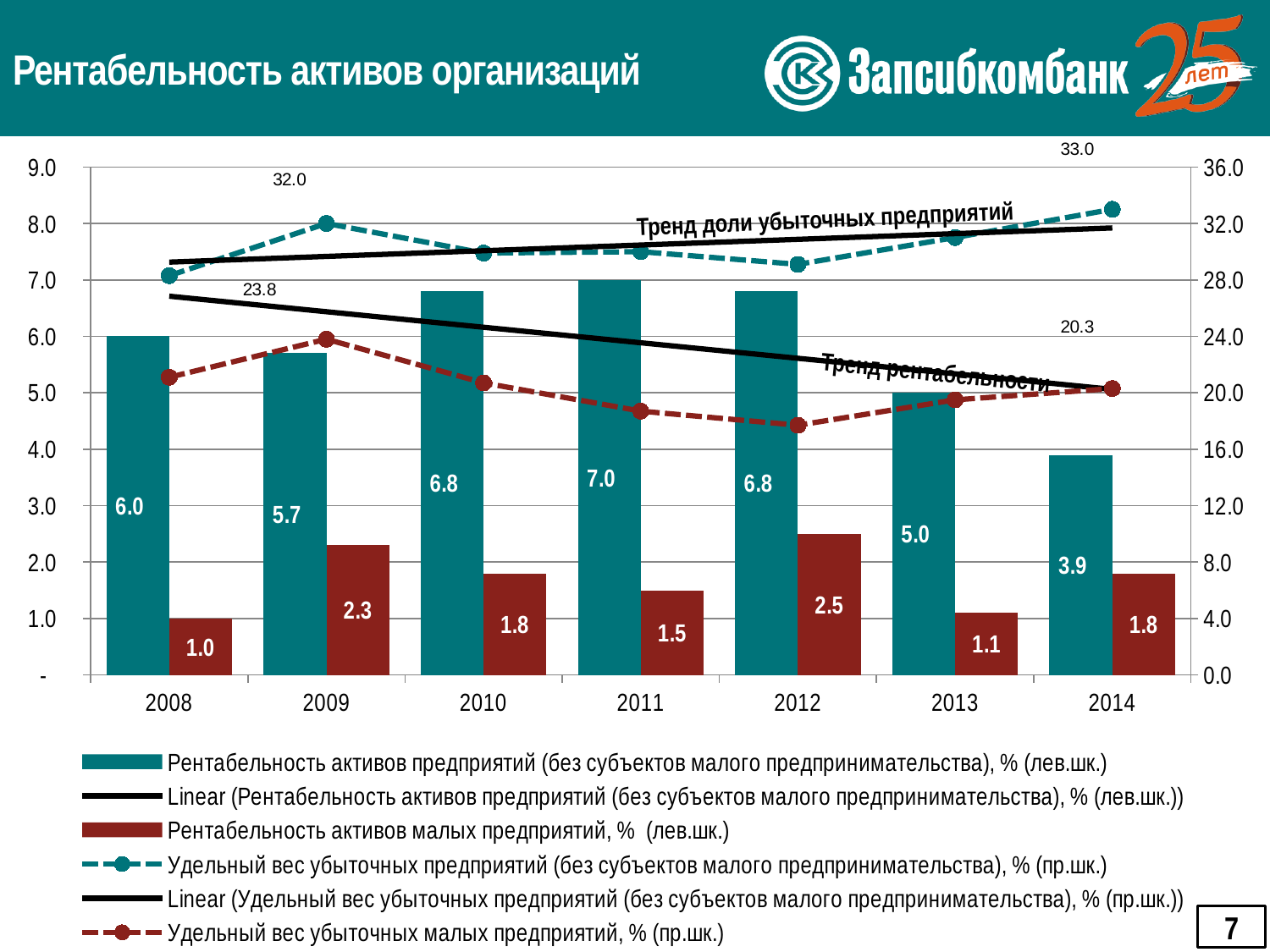
What is the value of the teal bar (Рентабельность активов предприятий, без субъектов малого предпринимательства) for 2011? 7.0 In which year is the dark red bar (Рентабельность активов малых предприятий) lowest? 2008 How many series does the legend list? 6 What is the labelled value of the teal dashed line (Удельный вес убыточных предприятий, без субъектов малого предпринимательства) in 2014? 33.0 Do the teal bars (Рентабельность активов предприятий, без субъектов малого предпринимательства) rise or fall from 2011 to 2014? fall Is the value of the dark red dashed line (Удельный вес убыточных малых предприятий) in 2012 greater or less than 20.0 on the right axis? less In which year is the teal bar (Рентабельность активов предприятий, без субъектов малого предпринимательства) highest? 2011 In which year is the teal bar (Рентабельность активов предприятий, без субъектов малого предпринимательства) lowest? 2014 How many years are shown on the x axis? 7 What is the difference between the teal bar and the dark red bar in 2008? 5.0 Which year has the larger dark red bar (Рентабельность активов малых предприятий): 2009 or 2010? 2009 What is the value of the dark red bar (Рентабельность активов малых предприятий) for 2012? 2.5